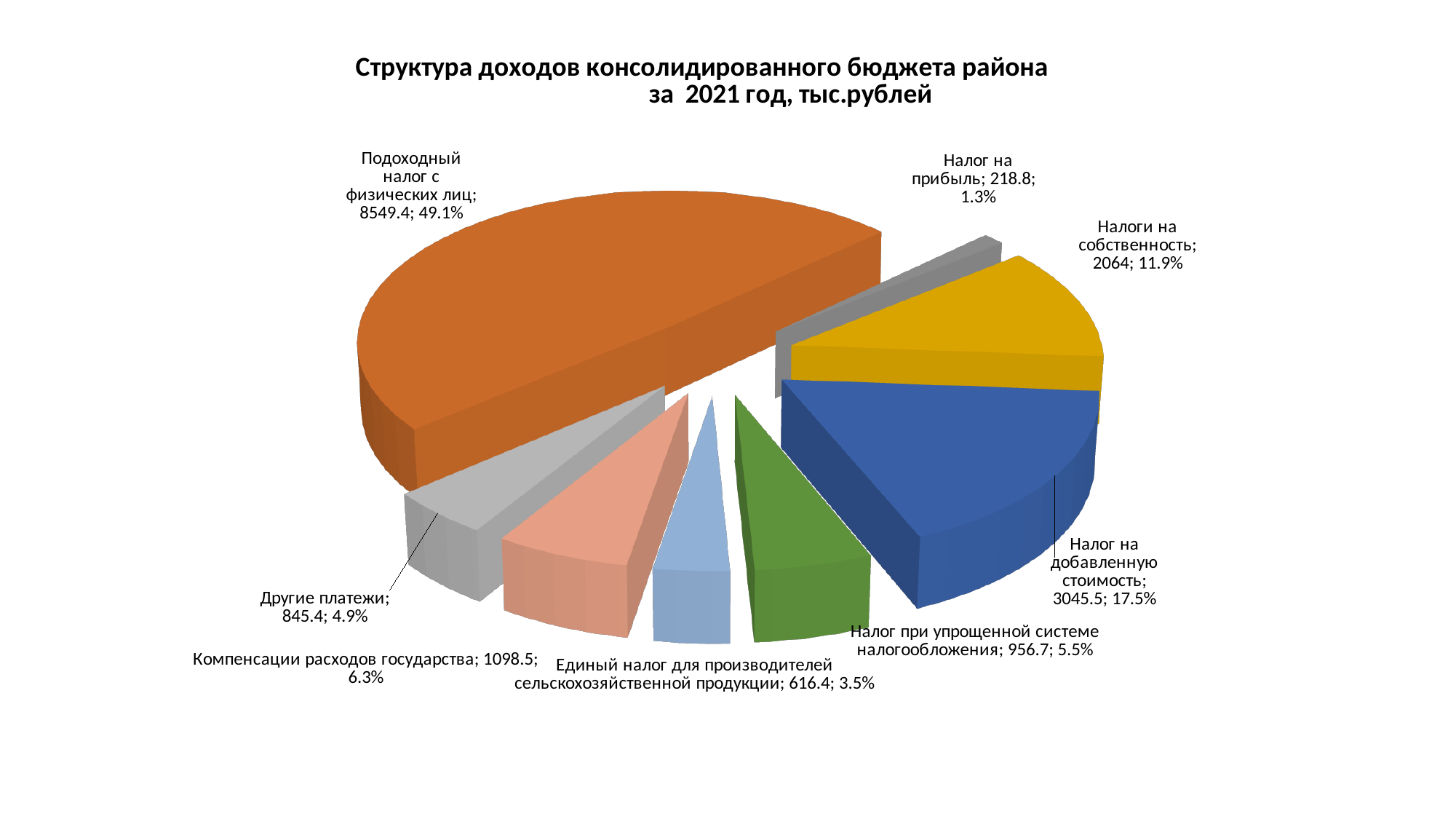
What is the value for Налог при упрощенной системе налогообложения? 956.7 What is the value for Подоходный налог с физических лиц? 8549.4 What is the value for Налог на добавленную стоимость? 3045.5 What kind of chart is shown on the slide? pie chart Which category has the largest share of the pie? Подоходный налог с физических лиц What is the title of the chart? Структура доходов консолидированного бюджета района за 2021 год, тыс.рублей Which category has the smallest share of the pie? Налог на прибыль What is the difference between the values for Налог на добавленную стоимость and Налоги на собственность? 981.5 How many slices does the pie chart have? 8 What share of the pie does Налоги на собственность represent? 11.9% Which is larger: Компенсации расходов государства or Другие платежи? Компенсации расходов государства What share of the pie does Единый налог для производителей сельскохозяйственной продукции represent? 3.5%